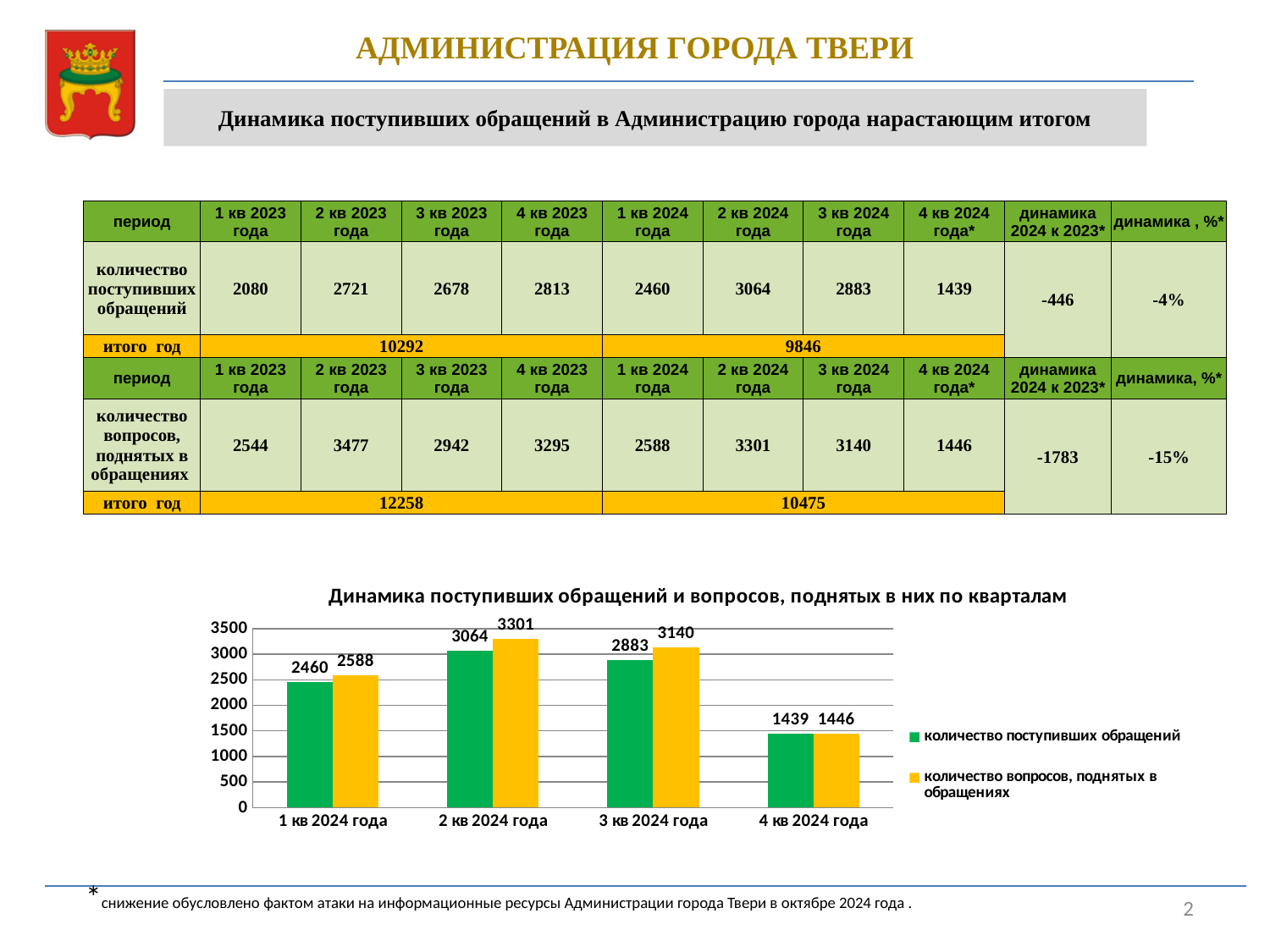
In which quarter is "количество поступивших обращений" highest? 2 кв 2024 года Which is larger in 3 кв 2024 года: "количество поступивших обращений" or "количество вопросов, поднятых в обращениях"? количество вопросов, поднятых в обращениях What is the value for "количество вопросов, поднятых в обращениях" in 4 кв 2024 года? 1446 What type of chart is shown on the slide? bar chart What is the title of the chart? Динамика поступивших обращений и вопросов, поднятых в них по кварталам What is the difference between "количество вопросов, поднятых в обращениях" and "количество поступивших обращений" in 2 кв 2024 года? 237 How many quarters are shown on the x axis of the chart? 4 How many series does the chart legend list? 2 What is the value for "количество вопросов, поднятых в обращениях" in 3 кв 2024 года? 3140 Is the value for "количество поступивших обращений" in 4 кв 2024 года greater or less than 1500? less What is the value for "количество поступивших обращений" in 1 кв 2024 года? 2460 In which quarter is "количество вопросов, поднятых в обращениях" lowest? 4 кв 2024 года